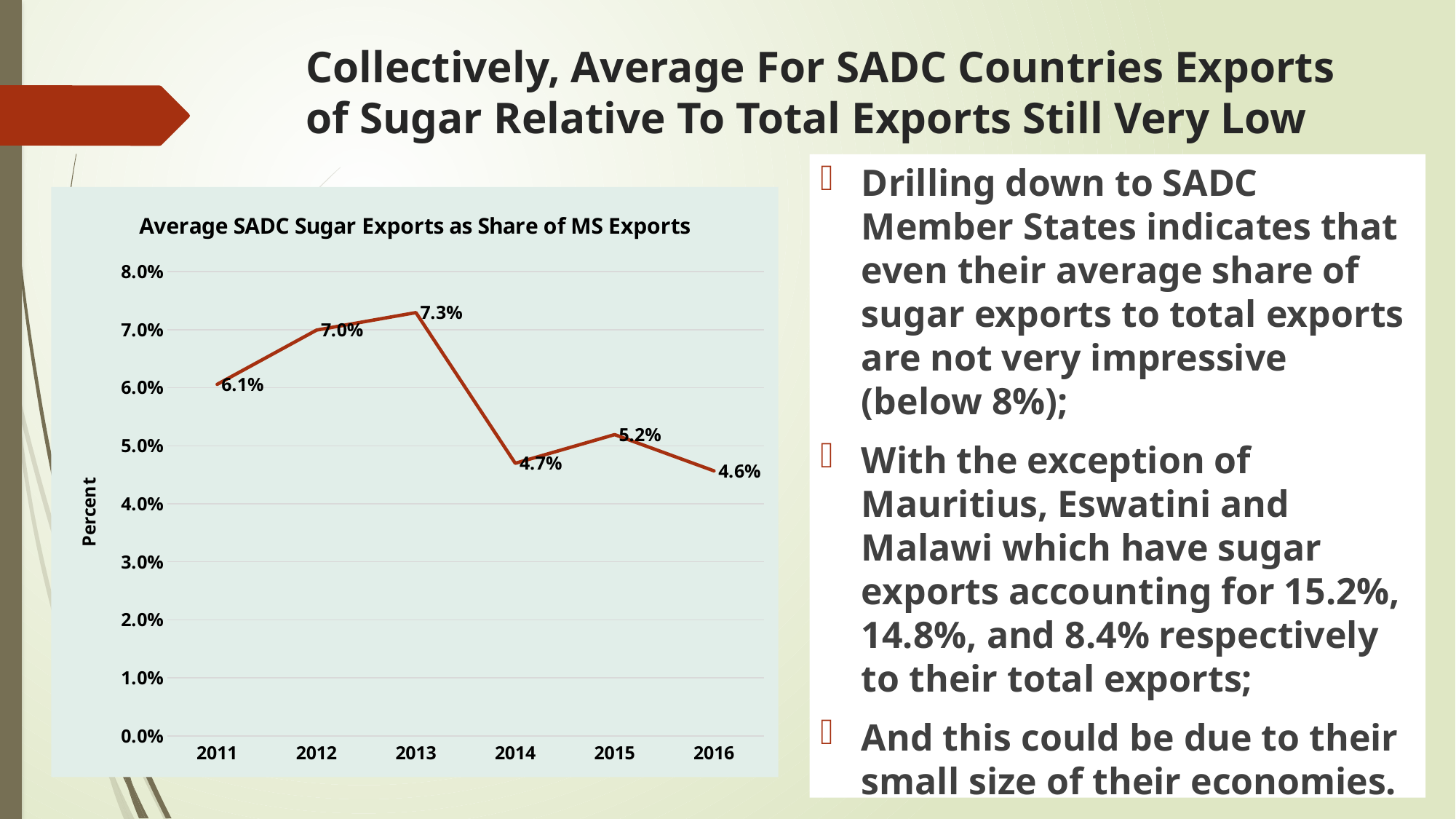
Which year has the highest average SADC sugar export share? 2013 Is the value for 2014 greater or less than 5.0%? less What is the average SADC sugar export share in 2013? 7.3% What is the difference between the 2013 and 2014 values? 2.6% Which year has a larger value, 2012 or 2015? 2012 Does the value rise or fall from 2013 to 2016 overall? fall What kind of chart is shown on the slide? line chart What is the average SADC sugar export share in 2016? 4.6% How many years are plotted on the chart? 6 Which year has the lowest average SADC sugar export share? 2016 What is the title of the chart? Average SADC Sugar Exports as Share of MS Exports What is the average SADC sugar export share in 2011? 6.1%